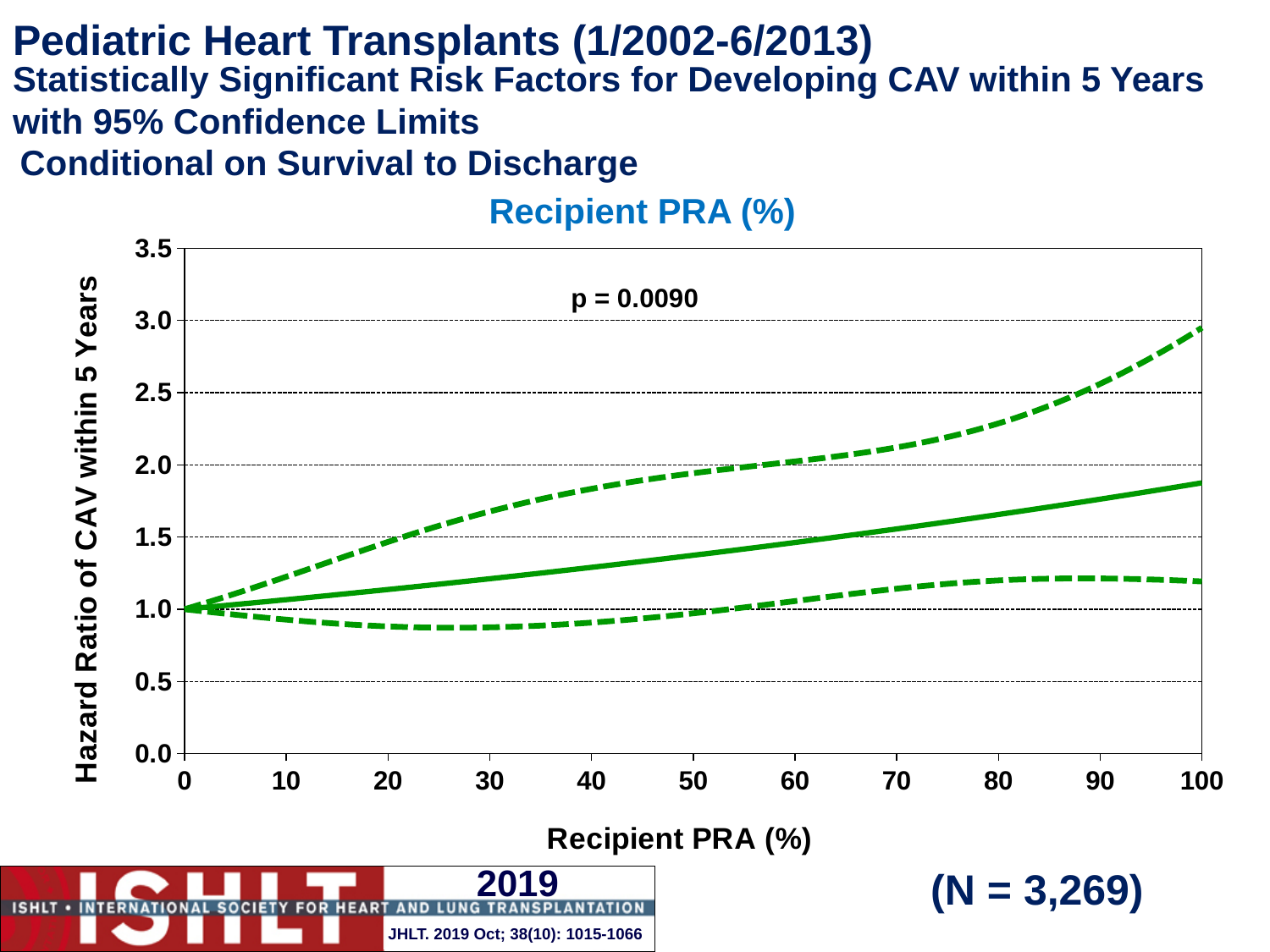
Is the value of the solid line at a Recipient PRA of 50% greater or less than 1.0? greater What p-value is printed on the chart? p = 0.0090 What is the title shown above the chart? Recipient PRA (%) Is the value of the lower dashed confidence limit at a Recipient PRA of 100% greater or less than 1.5? less Is the value of the lower dashed confidence limit at a Recipient PRA of 30% greater or less than 1.0? less What kind of chart is shown on the slide? line chart Does the solid hazard ratio line rise or fall as Recipient PRA increases from 0 to 100? rises What is the hazard ratio of the solid line at a Recipient PRA of 0%? 1.0 What is the sample size (N) shown on the slide? N = 3,269 What is the label of the y axis? Hazard Ratio of CAV within 5 Years